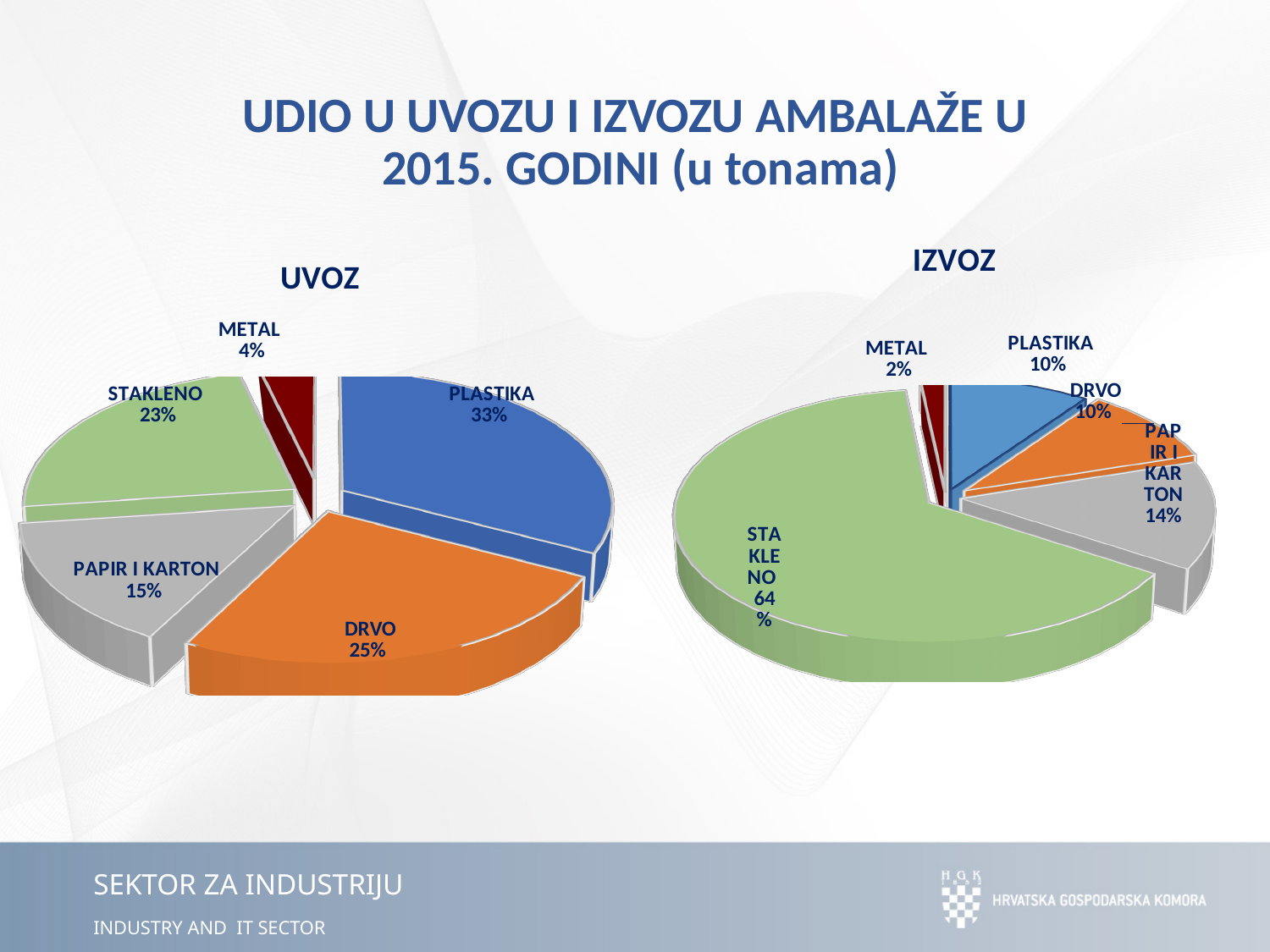
In the IZVOZ chart, which is larger, the share of PAPIR I KARTON or the share of PLASTIKA? PAPIR I KARTON In the IZVOZ chart, what share does PAPIR I KARTON have? 14% In the IZVOZ chart, what share does STAKLENO have? 64% In the UVOZ chart, what share does STAKLENO have? 23% In the UVOZ chart, how many categories are shown? 5 In the UVOZ chart, what share does PLASTIKA have? 33% In the UVOZ chart, which category has the largest share? PLASTIKA What is the title of the slide? UDIO U UVOZU I IZVOZU AMBALAŽE U 2015. GODINI (u tonama) In the UVOZ chart, what is the difference between the shares of DRVO and PAPIR I KARTON? 10% What kind of chart is the IZVOZ chart? Pie chart In the UVOZ chart, which category has the smallest share? METAL In the IZVOZ chart, which category has the smallest share? METAL